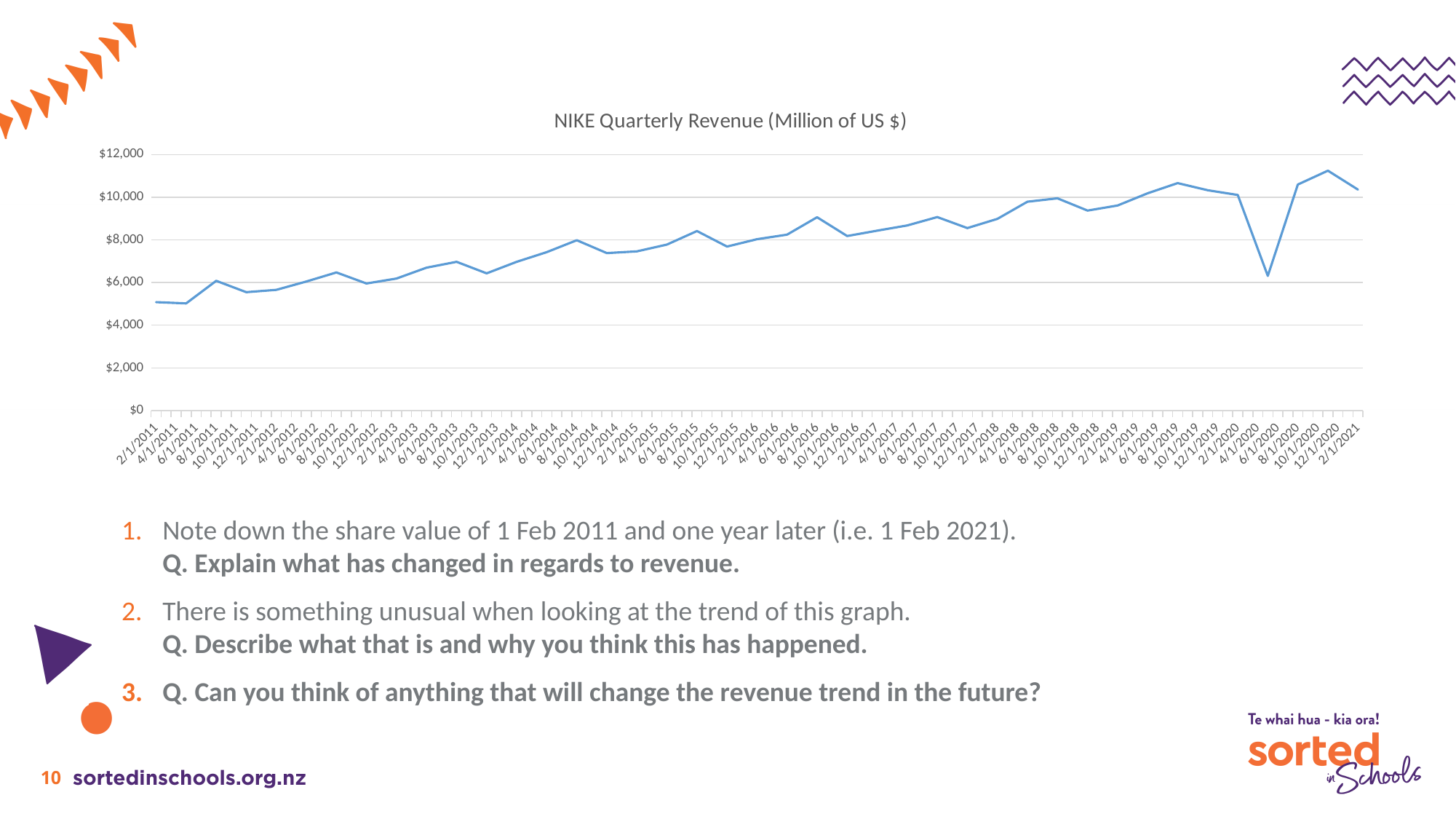
Is the value for 6/1/2020 greater or less than $8,000? less Which date has the highest revenue on the chart? 12/1/2020 Which date in 2020 has the lowest revenue on the chart? 6/1/2020 Is the value for 2/1/2011 greater or less than $6,000? less Is the value for 2/1/2011 greater or less than $4,000? greater What kind of chart is shown on the slide? line chart What is the highest value shown on the y axis? $12,000 What is the title of the chart? NIKE Quarterly Revenue (Million of US $) Which is larger, the value for 2/1/2011 or the value for 2/1/2021? 2/1/2021 Overall, do the values rise or fall from 2/1/2011 to 2/1/2021? rise